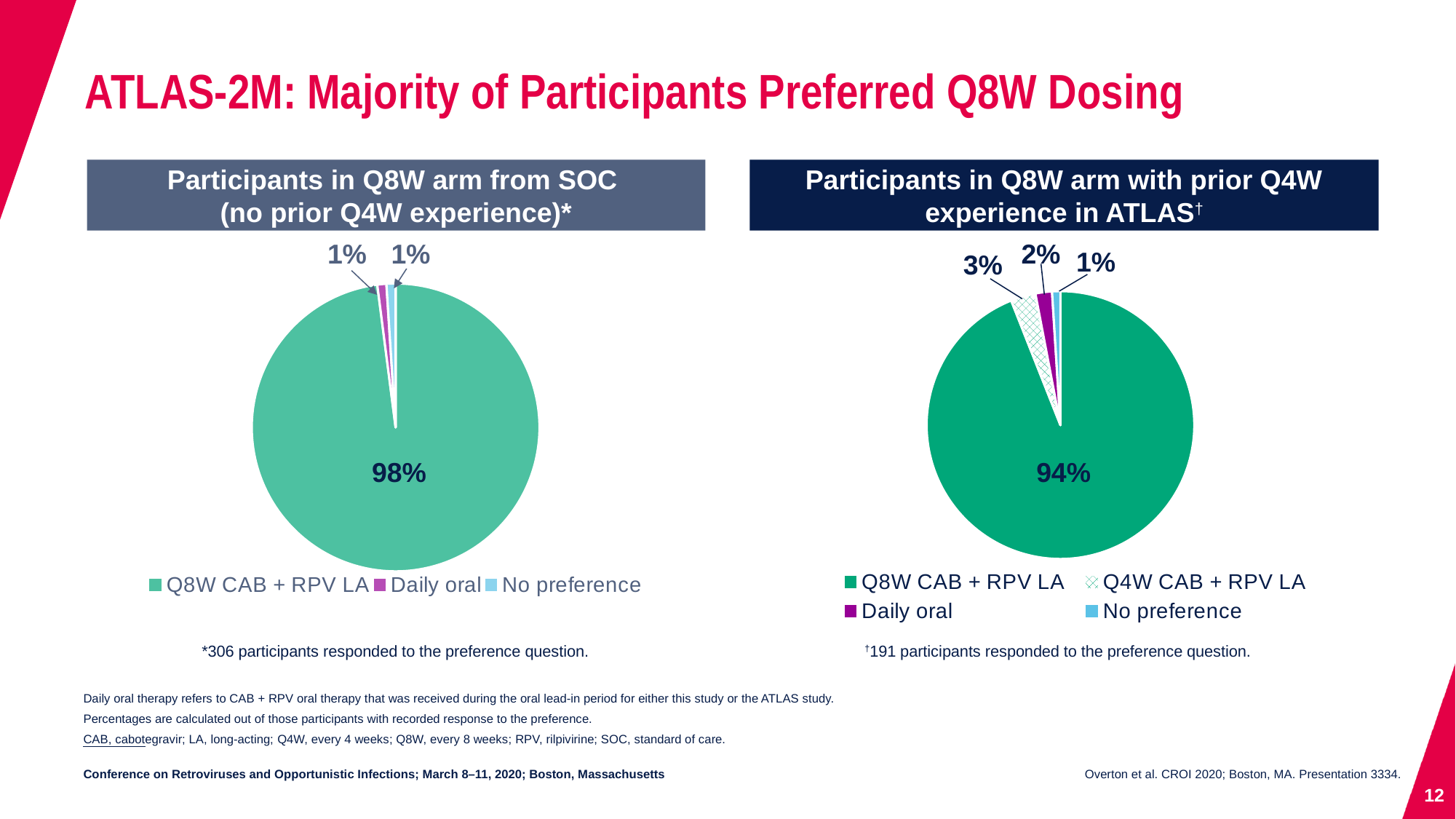
In the right pie chart (prior Q4W experience), which category has the smallest share? No preference In the right pie chart (prior Q4W experience), which is larger: the share for Q4W CAB + RPV LA or the share for Daily oral? Q4W CAB + RPV LA In the right pie chart (prior Q4W experience), what share of participants had No preference? 1% In the right pie chart (prior Q4W experience), what share of participants preferred Daily oral? 2% What is the difference between the Q8W CAB + RPV LA share in the left pie chart and the Q8W CAB + RPV LA share in the right pie chart? 4 percentage points In the right pie chart (prior Q4W experience), what share of participants preferred Q4W CAB + RPV LA? 3% In the left pie chart (Participants in Q8W arm from SOC), what share of participants preferred Q8W CAB + RPV LA? 98% In the right pie chart (Participants in Q8W arm with prior Q4W experience in ATLAS), what share of participants preferred Q8W CAB + RPV LA? 94% In the left pie chart (no prior Q4W experience), which category has the largest share? Q8W CAB + RPV LA In the left pie chart (no prior Q4W experience), what share of participants preferred Daily oral? 1% How many categories does the legend of the right pie chart (prior Q4W experience) list? 4 What type of chart is used on this slide? Pie chart